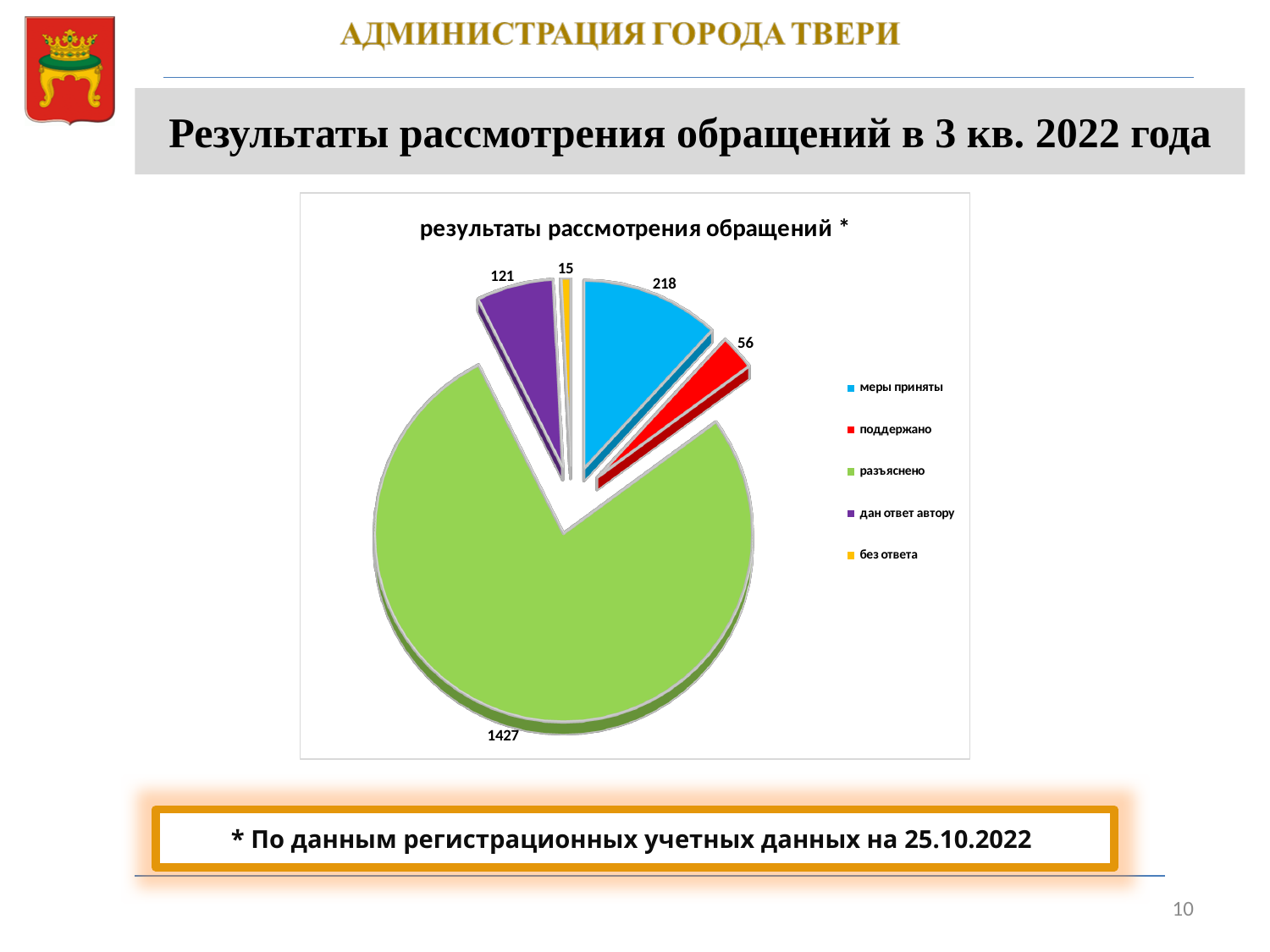
Which category has the largest slice in the pie chart? разъяснено What is the value for «дан ответ автору» in the pie chart? 121 What type of chart is shown on the slide? Pie chart What is the title of the pie chart? результаты рассмотрения обращений * Which category has the smallest slice in the pie chart? без ответа What is the difference between the values for «меры приняты» and «дан ответ автору»? 97 What is the value for «меры приняты» in the pie chart? 218 Which is larger: the value for «поддержано» or the value for «дан ответ автору»? дан ответ автору What is the value for «поддержано» in the pie chart? 56 What is the value for «без ответа» in the pie chart? 15 What is the value for «разъяснено» in the pie chart? 1427 How many categories does the pie chart legend list? 5